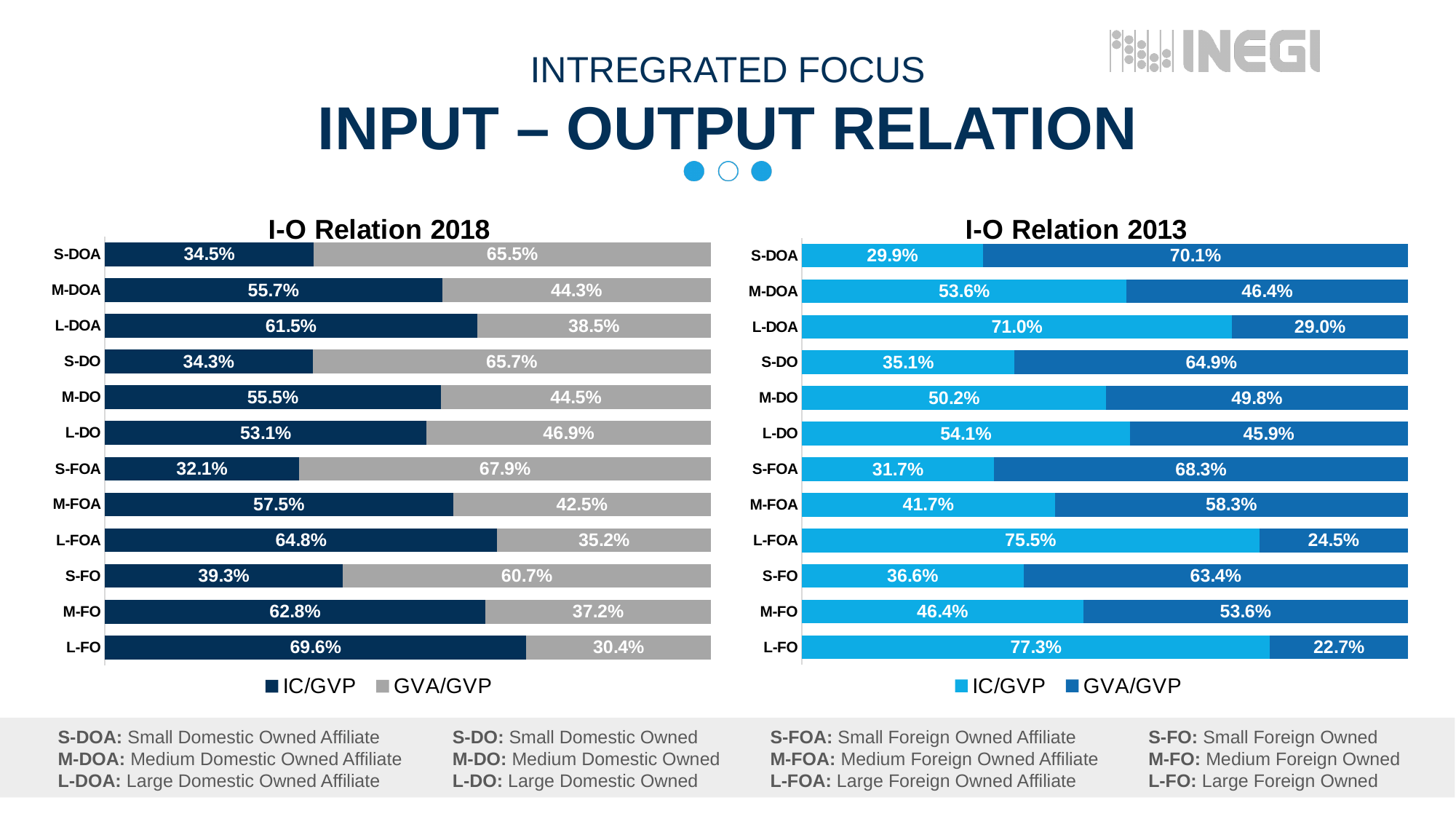
How many series does the legend of the I-O Relation 2013 chart list? 2 In the I-O Relation 2013 chart, which category has the highest IC/GVP value? L-FO In the I-O Relation 2013 chart, which is larger: the IC/GVP value for L-DOA or for M-DOA? L-DOA In the I-O Relation 2013 chart, what is the GVA/GVP value for S-DOA? 70.1% In the I-O Relation 2013 chart, which category has the lowest IC/GVP value? S-DOA What kind of chart is the I-O Relation 2018 chart? Stacked bar chart In the I-O Relation 2018 chart, what is the GVA/GVP value for M-FOA? 42.5% In the I-O Relation 2018 chart, what is the difference between the IC/GVP values for L-FO and S-DOA? 35.1 percentage points How many categories are shown in the I-O Relation 2018 chart? 12 In the I-O Relation 2018 chart, which category has the lowest IC/GVP value? S-FOA In the I-O Relation 2018 chart, what is the IC/GVP value for L-FO? 69.6% In the I-O Relation 2013 chart, what is the total of the stacked bar for L-FOA? 100%